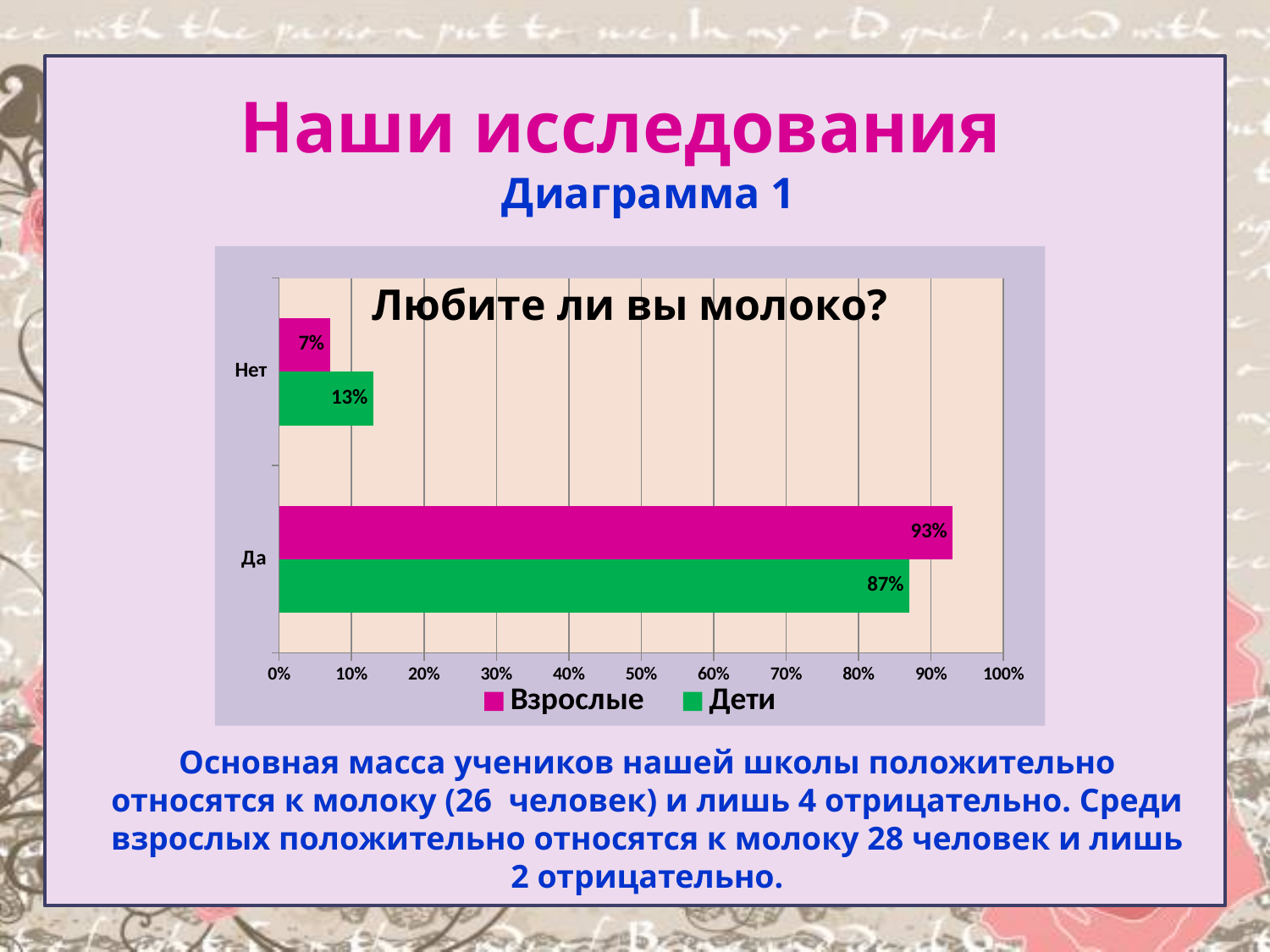
What kind of chart is shown on the slide? Bar chart In the Нет category, which series has the larger value, Взрослые or Дети? Дети Which category has the highest value for Дети? Да What is the title of the chart? Любите ли вы молоко? What is the value for Дети in the Нет category? 13% What is the value for Взрослые in the Нет category? 7% What is the value for Дети in the Да category? 87% What is the value for Взрослые in the Да category? 93% What is the difference between the Взрослые and Дети values in the Да category? 6% How many series does the legend list? 2 How many categories are shown on the chart? 2 Which category has the lowest value for Взрослые? Нет